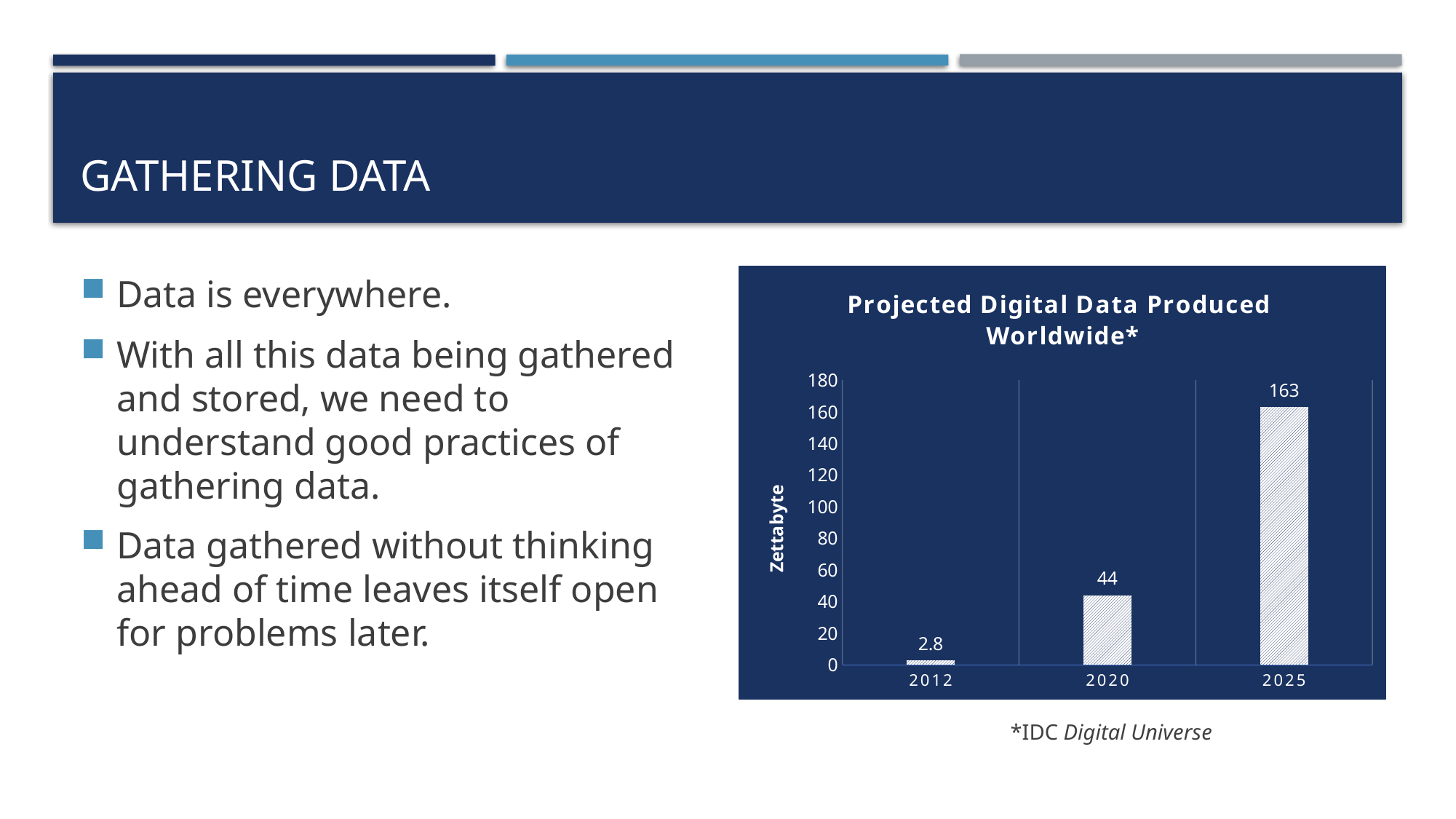
What kind of chart is shown on the slide? Bar chart Which year has the highest projected digital data produced? 2025 How many years are shown on the chart? 3 What is the value shown for 2012? 2.8 What is the projected digital data produced worldwide in 2025? 163 What is the value shown for 2020? 44 What is the difference between the values for 2020 and 2012? 41.2 Which is larger, the value for 2020 or the value for 2012? 2020 What is the label on the vertical axis of the chart? Zettabyte What is the difference between the values for 2025 and 2020? 119 Which year has the lowest value on the chart? 2012 Is the value for 2025 greater or less than 140? greater